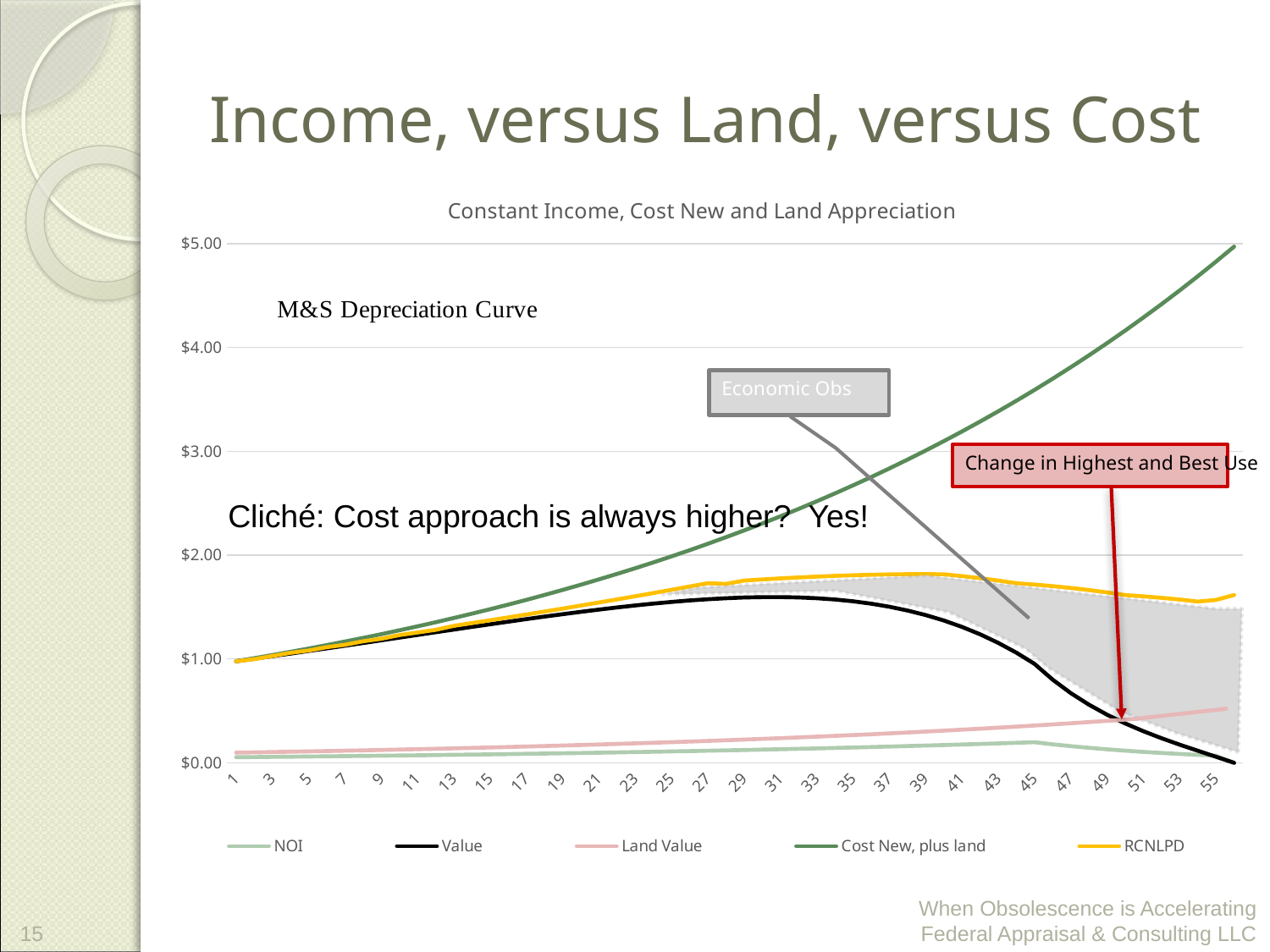
Does the Land Value series rise or fall as x increases from 1 to 55? rise Which series does the legend list between Value and Cost New, plus land? Land Value Does the Cost New, plus land series rise or fall as x increases from 1 to 55? rise Is the value of the RCNLPD series at x = 39 greater or less than $1.00? greater What kind of chart is shown on the slide? line chart At x = 55, which series is higher: RCNLPD or Value? RCNLPD Is the value of the NOI series at x = 45 greater or less than $1.00? less What is the title of the chart? Constant Income, Cost New and Land Appreciation Which series reaches the highest value anywhere on the chart? Cost New, plus land Is the value of the Cost New, plus land series at x = 55 greater or less than $4.00? greater How many series does the chart's legend list? 5